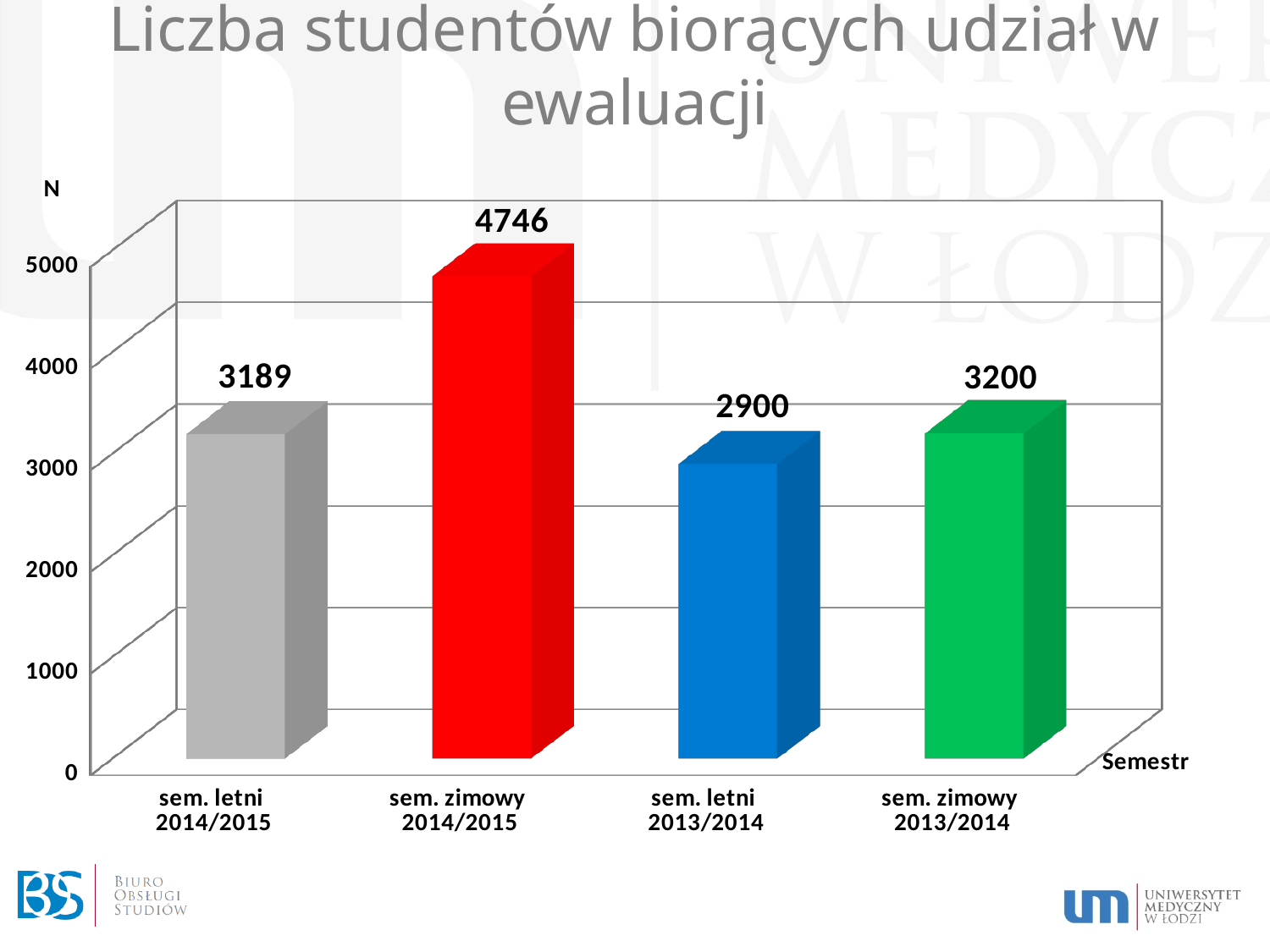
What is the title of the chart? Liczba studentów biorących udział w ewaluacji Which semester has the highest number of students participating in the evaluation? sem. zimowy 2014/2015 What is the number of students for sem. zimowy 2014/2015? 4746 What is the value shown for sem. letni 2014/2015? 3189 Which is larger: the value for sem. zimowy 2014/2015 or sem. zimowy 2013/2014? sem. zimowy 2014/2015 Which semester has the lowest number of students participating in the evaluation? sem. letni 2013/2014 What is the value shown for sem. zimowy 2013/2014? 3200 What kind of chart is shown on the slide? bar chart What is the number of students for sem. letni 2013/2014? 2900 What is the difference between the values for sem. zimowy 2013/2014 and sem. letni 2013/2014? 300 How many semesters are shown on the chart? 4 What is the difference between the values for sem. zimowy 2014/2015 and sem. letni 2014/2015? 1557